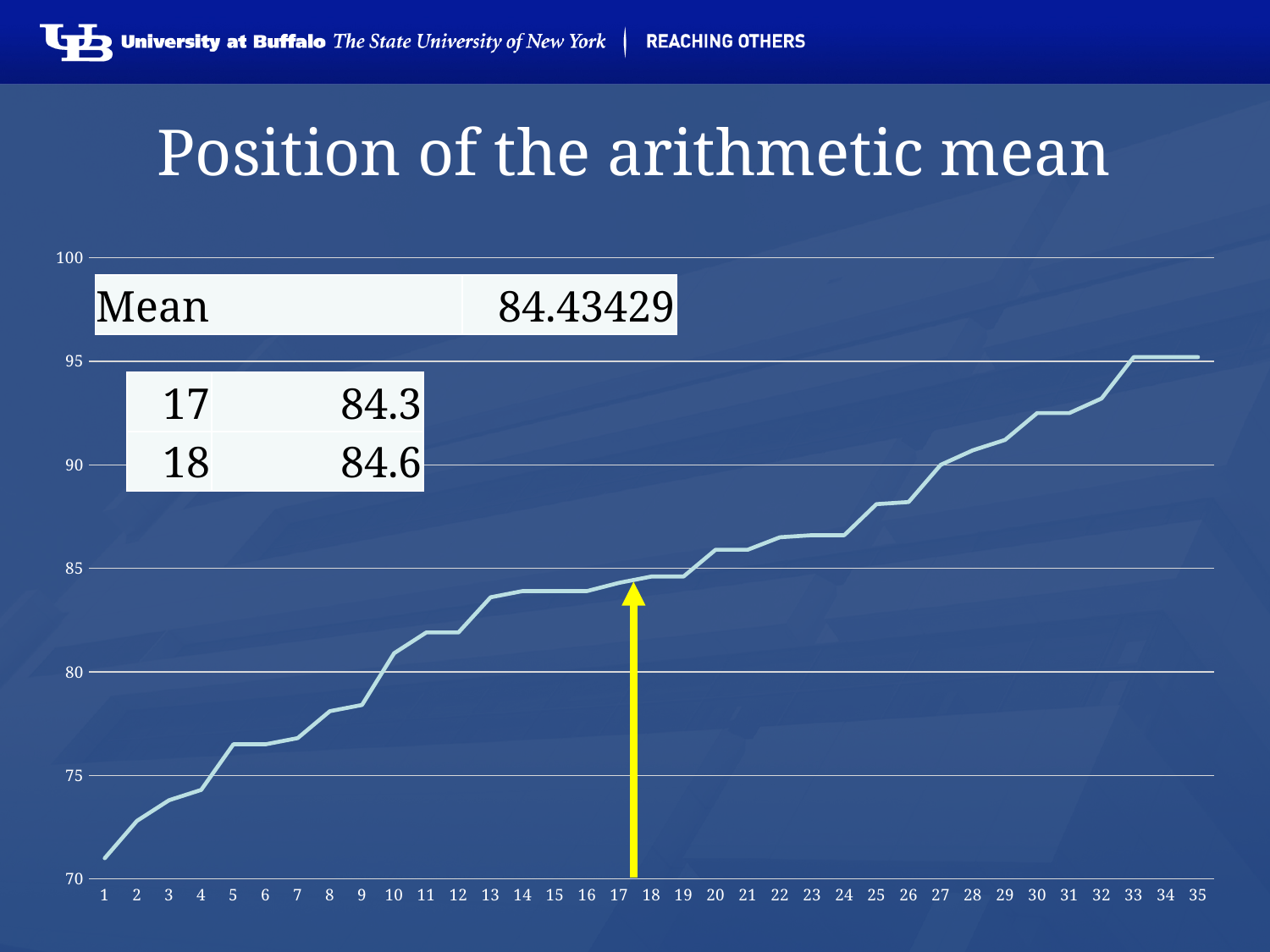
What is the title of the chart? Position of the arithmetic mean Which has the larger value, position 17 or position 18? 18 How many points are plotted along the x axis? 35 Which position has the lowest value? 1 What is the mean value printed on the slide? 84.43429 What is the value shown for position 18? 84.6 What kind of chart is shown on the slide? line chart Do the values rise or fall as the x axis goes from 1 to 35? rise What is the difference between the values at positions 18 and 17? 0.3 Is the value for position 1 greater or less than 75? less Is the value for position 25 greater or less than 85? greater What is the value shown for position 17? 84.3